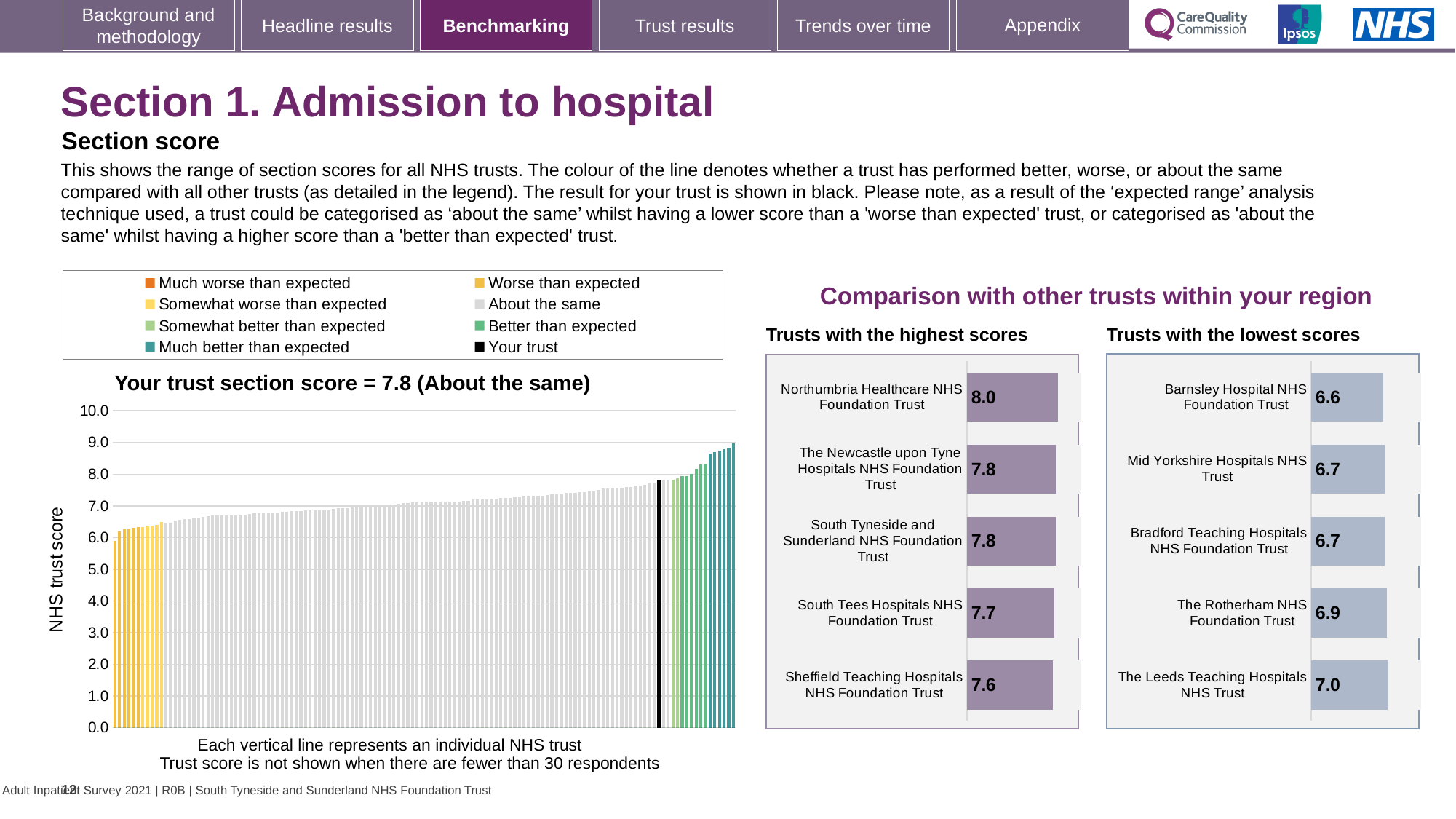
On the 'Your trust section score' chart, do the bars rise or fall from left to right? rise On the 'Trusts with the highest scores' chart, what is the score for Northumbria Healthcare NHS Foundation Trust? 8.0 On the 'Trusts with the highest scores' chart, what is the difference between the scores of Northumbria Healthcare NHS Foundation Trust and Sheffield Teaching Hospitals NHS Foundation Trust? 0.4 How many entries does the legend above the 'Your trust section score' chart list? 8 On the 'Trusts with the lowest scores' chart, which has the higher score: The Rotherham NHS Foundation Trust or Mid Yorkshire Hospitals NHS Trust? The Rotherham NHS Foundation Trust On the 'Trusts with the highest scores' chart, which trust has the lowest score? Sheffield Teaching Hospitals NHS Foundation Trust How many trusts are shown on the 'Trusts with the highest scores' chart? 5 What kind of chart is the 'Your trust section score' chart? bar chart On the 'Trusts with the lowest scores' chart, which trust has the lowest score? Barnsley Hospital NHS Foundation Trust On the 'Your trust section score' chart, what is the section score for your trust? 7.8 On the 'Trusts with the lowest scores' chart, what is the score for The Leeds Teaching Hospitals NHS Trust? 7.0 On the 'Your trust section score' chart, is the value of the rightmost bar greater or less than 8.0? greater